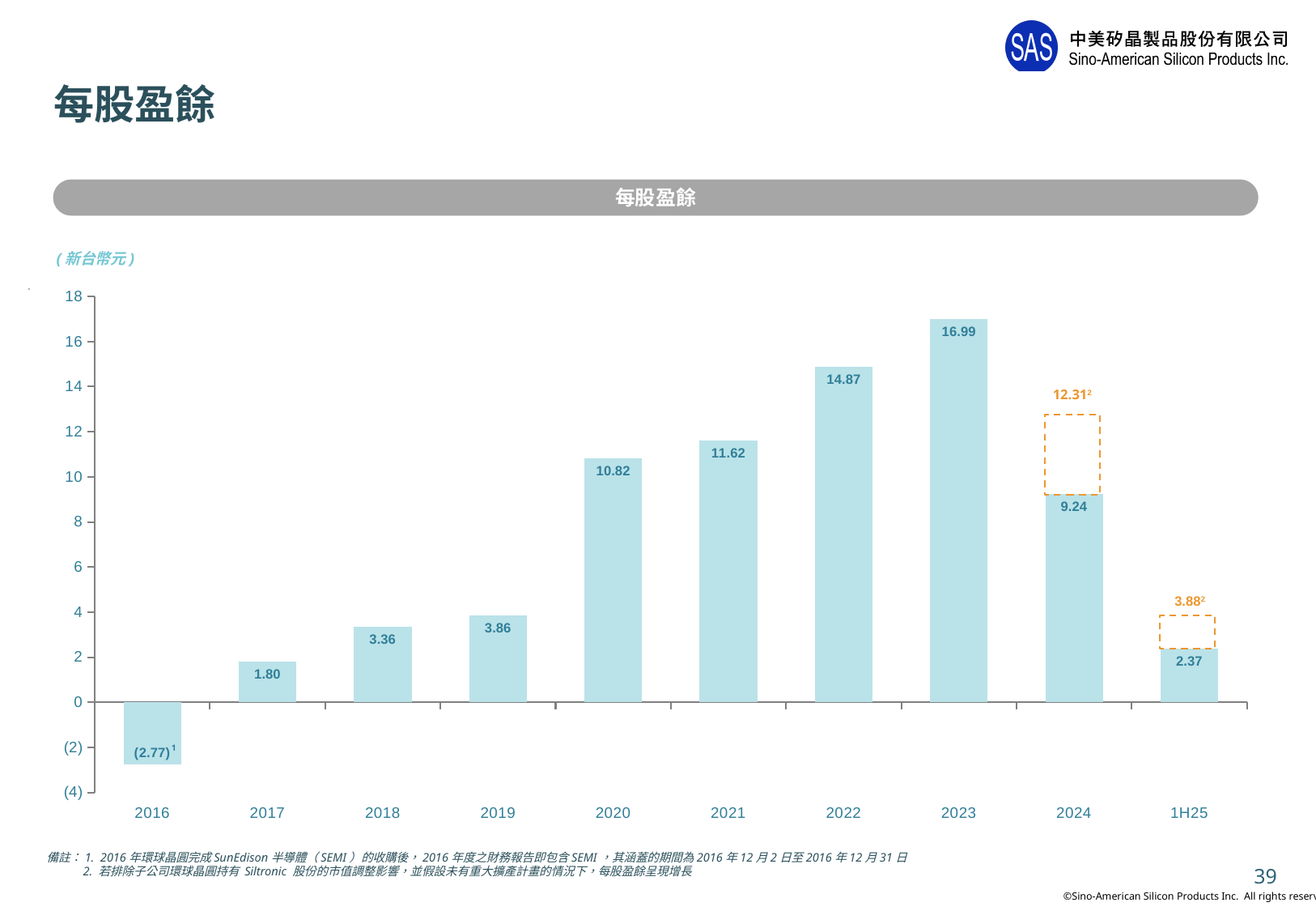
How many categories are shown on the x axis of the chart? 10 Which year has the highest EPS on the chart? 2023 What is the EPS value shown for 2023? 16.99 What is the difference between the EPS for 2023 and the EPS for 2022? 2.12 What is the EPS value shown for 2020? 10.82 What unit is stated for the values in the chart? 新台幣元 Which year has the lowest EPS on the chart? 2016 What is the solid-bar EPS value shown for 2024? 9.24 What kind of chart is shown on the slide? bar chart What is the dashed-box adjusted EPS value shown above the 2024 bar? 12.31 What is the EPS value shown for 2016? (2.77) Which is larger, the EPS for 2021 or the EPS for 2020? 2021